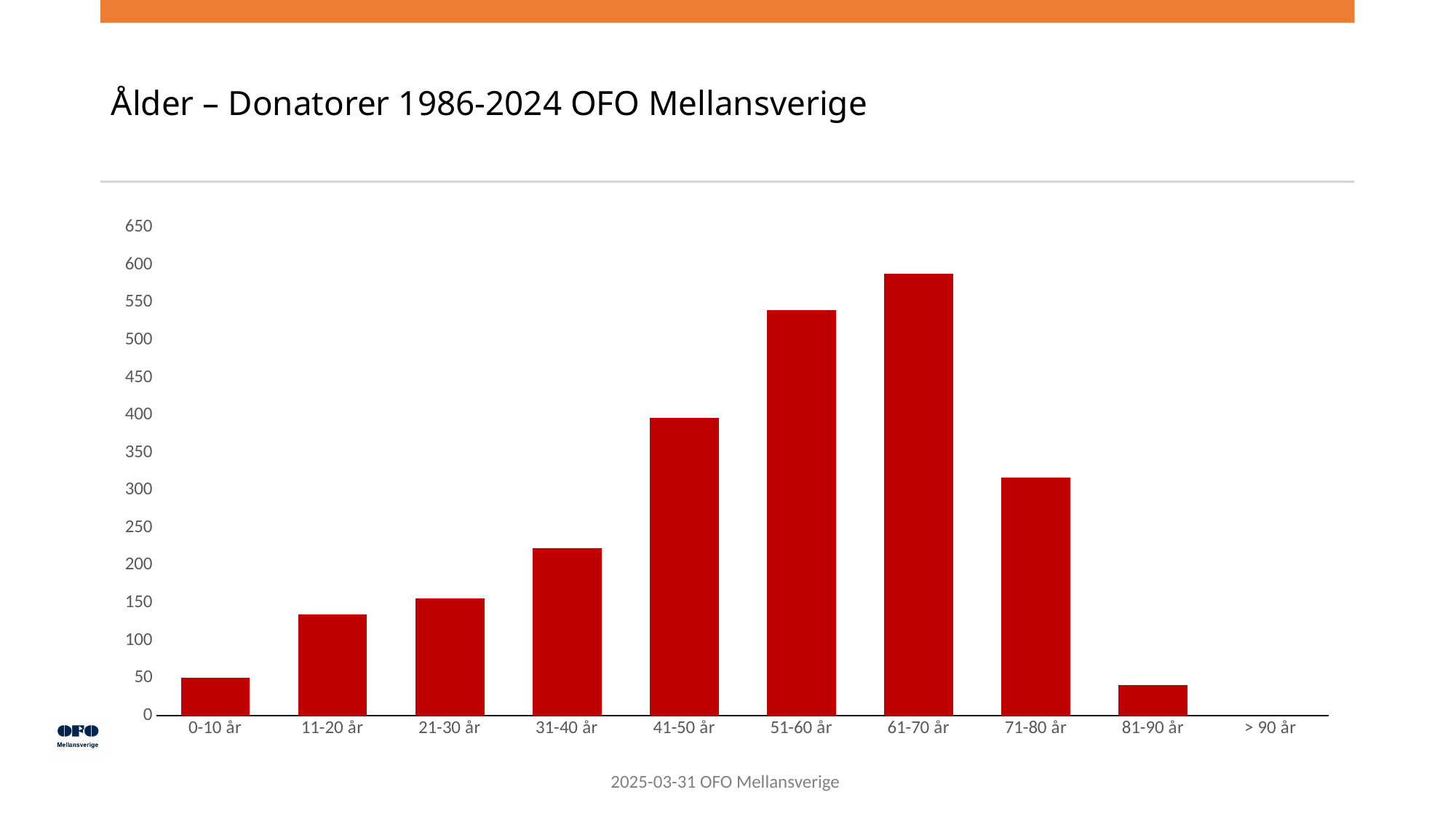
What is the title of the chart? Ålder – Donatorer 1986-2024 OFO Mellansverige Is the value for 51-60 år greater or less than 500? greater Which age group has the highest bar? 61-70 år How do the values change from 0-10 år up to 61-70 år? they rise Is the value for 31-40 år greater or less than 200? greater How many age categories are shown on the x axis? 10 Is the value for 41-50 år greater or less than 350? greater What kind of chart is shown on the slide? bar chart Which age group has no visible bar? > 90 år Among the age groups with a visible bar, which has the lowest value? 81-90 år Which is larger, the value for 51-60 år or the value for 71-80 år? 51-60 år